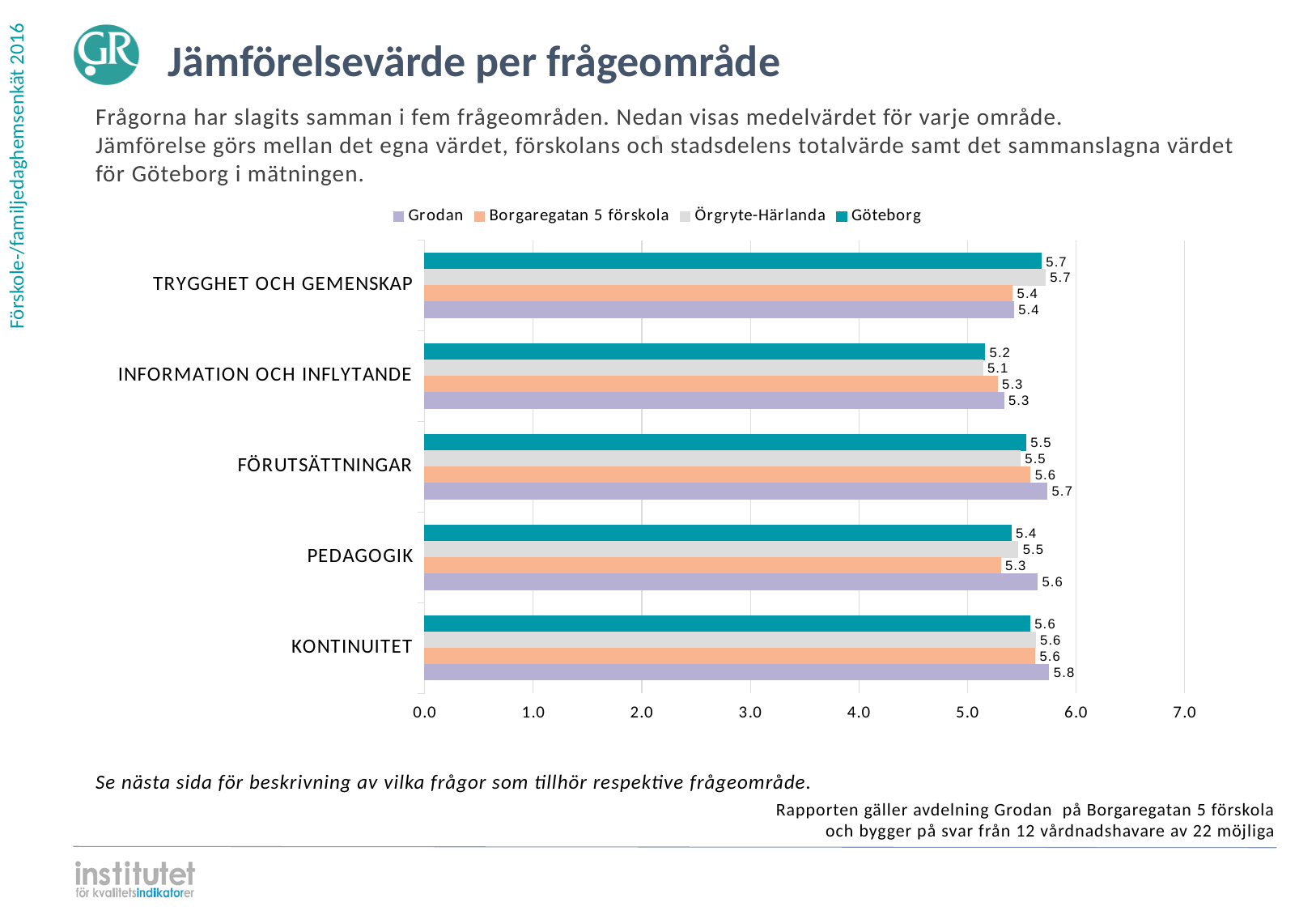
How many question areas (categories) are shown on the chart? 5 In the PEDAGOGIK category, which is larger: the value for Grodan or the value for Borgaregatan 5 förskola? Grodan In the TRYGGHET OCH GEMENSKAP category, what is the difference between the Göteborg value and the Grodan value? 0.3 In which category does Grodan have its lowest value? INFORMATION OCH INFLYTANDE What is the value for Göteborg in the INFORMATION OCH INFLYTANDE category? 5.2 What kind of chart is shown on the slide? Bar chart What is the title of the slide? Jämförelsevärde per frågeområde What is the value for Borgaregatan 5 förskola in the PEDAGOGIK category? 5.3 In which category does Grodan have its highest value? KONTINUITET How many series does the legend list? 4 What is the value for Grodan in the KONTINUITET category? 5.8 What is the value for Örgryte-Härlanda in the FÖRUTSÄTTNINGAR category? 5.5